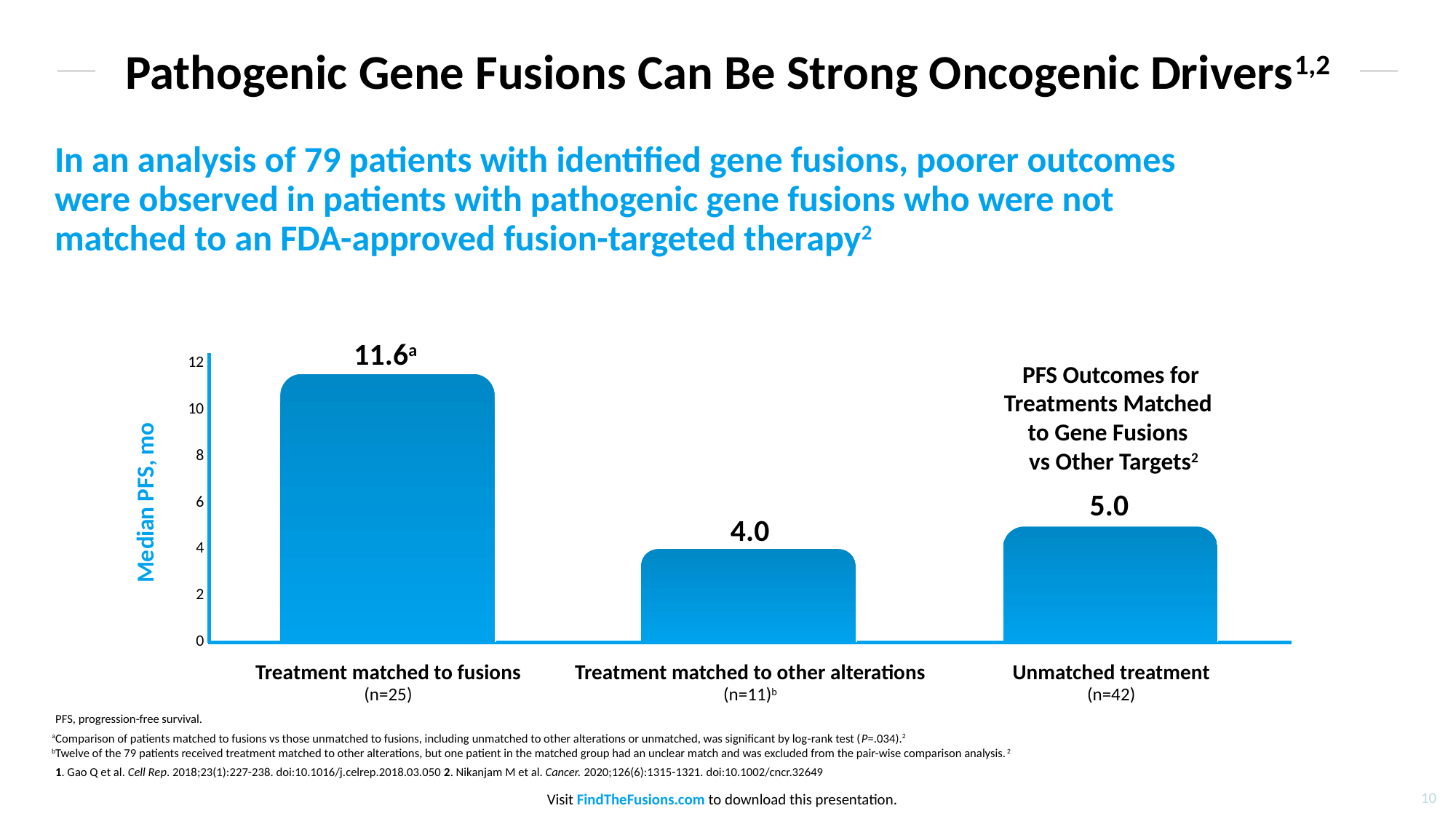
What is the difference in median PFS between Unmatched treatment and Treatment matched to other alterations? 1.0 How many treatment groups are shown in the chart? 3 What kind of chart is shown on the slide? Bar chart Which treatment group has the highest median PFS? Treatment matched to fusions What is the median PFS for Treatment matched to fusions? 11.6 What is the label of the y-axis of the chart? Median PFS, mo What is the median PFS for Treatment matched to other alterations? 4.0 What is the median PFS for Unmatched treatment? 5.0 Which treatment group has the lowest median PFS? Treatment matched to other alterations Which has a larger median PFS: Treatment matched to other alterations or Unmatched treatment? Unmatched treatment What is the difference in median PFS between Treatment matched to fusions and Unmatched treatment? 6.6 Is the median PFS for Treatment matched to fusions greater or less than 10? greater